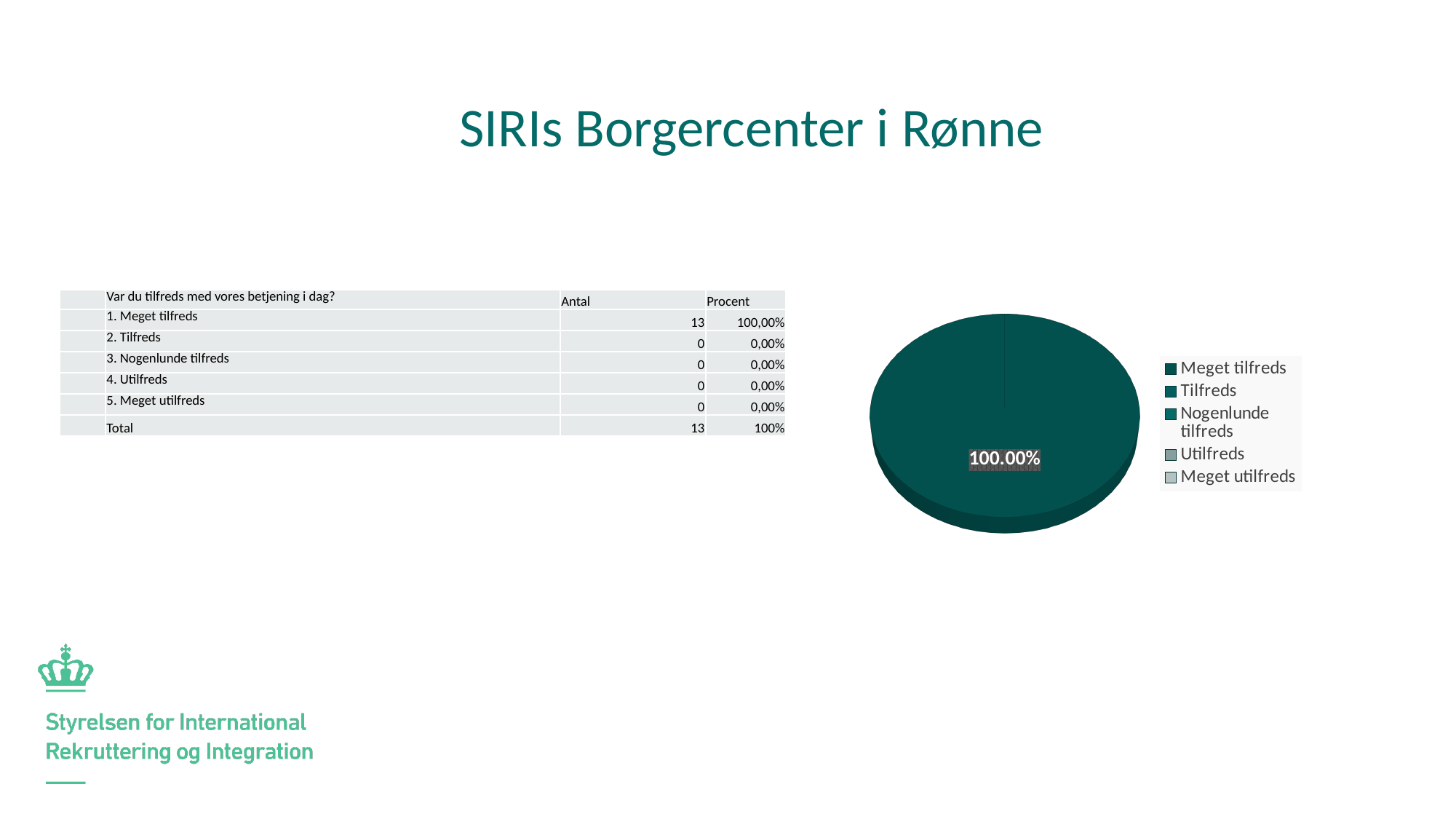
What kind of chart is shown on the slide? pie chart What is the first entry listed in the pie chart's legend? Meget tilfreds What share of the pie does the Meget tilfreds slice take? 100.00% What is the last entry listed in the pie chart's legend? Meget utilfreds What percentage is printed on the pie chart's data label? 100.00% How many slices are visible in the pie chart? 1 How many entries does the legend of the pie chart list? 5 Is the share shown for Meget tilfreds greater or less than 50%? greater Which category makes up the entire pie chart? Meget tilfreds